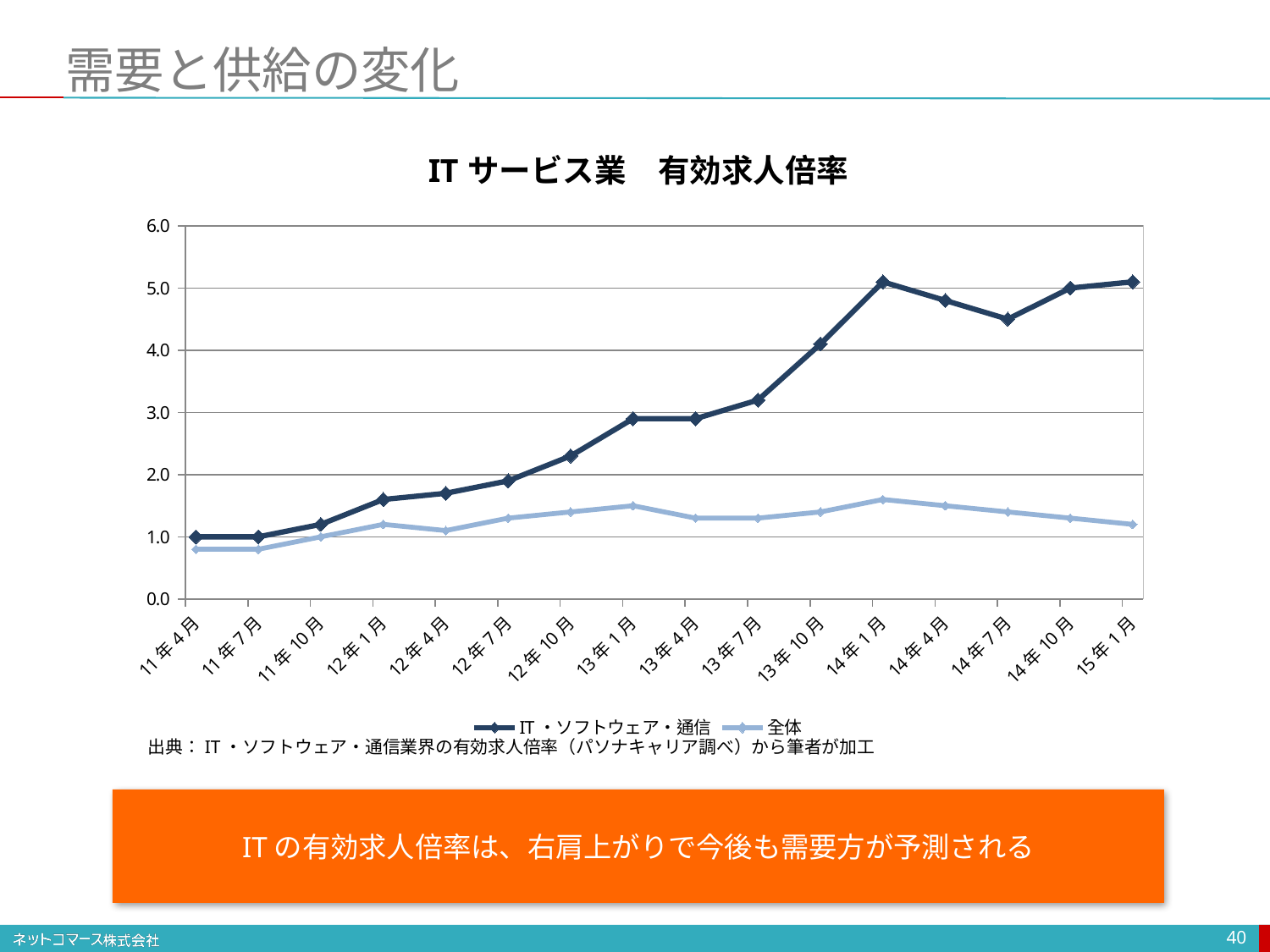
Is the value for IT・ソフトウェア・通信 at 13年10月 greater or less than 3.0? greater Does the IT・ソフトウェア・通信 series generally rise or fall from 11年4月 to 15年1月? rise Is the value for 全体 at 14年1月 greater or less than 2.0? less Is the value for IT・ソフトウェア・通信 at 12年10月 greater or less than 2.0? greater How many series does the legend list? 2 At 15年1月, which series has the larger value, IT・ソフトウェア・通信 or 全体? IT・ソフトウェア・通信 What is the title of the chart? IT サービス業 有効求人倍率 What kind of chart is shown on the slide? line chart What is the value for IT・ソフトウェア・通信 at 14年10月? 5.0 What are the two series named in the legend? IT・ソフトウェア・通信 and 全体 How many time points are plotted along the x axis? 16